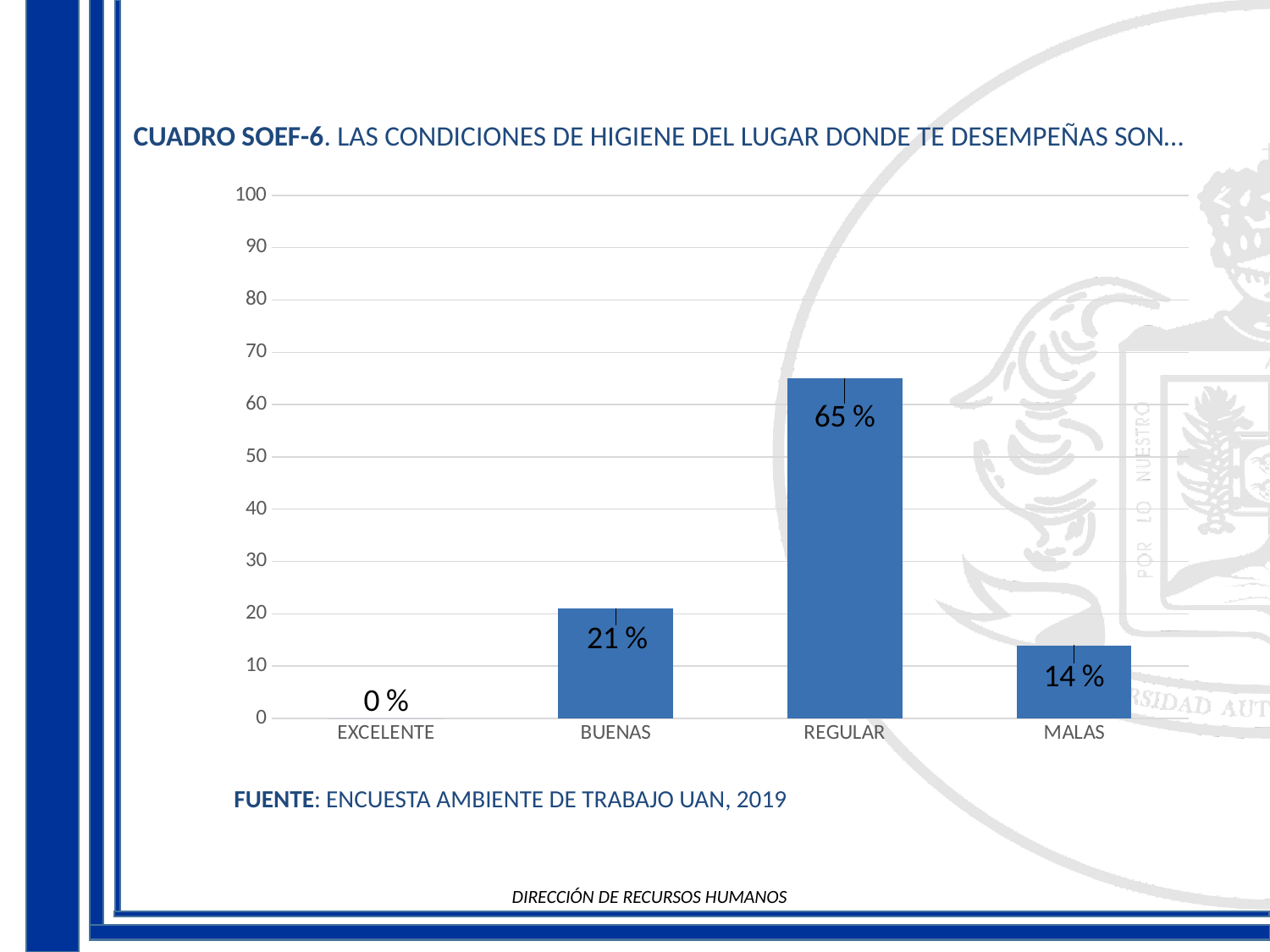
What is the value for REGULAR? 65 % What is the difference between the values for REGULAR and BUENAS? 44 % What is the value for BUENAS? 21 % Is the value for REGULAR greater or less than 60? greater Which category has the lowest value? EXCELENTE What is the difference between the values for BUENAS and MALAS? 7 % How many categories are shown on the x axis? 4 What kind of chart is shown on the slide? bar chart What is the value for MALAS? 14 % Which is larger, the value for BUENAS or the value for MALAS? BUENAS Which category has the highest value? REGULAR What is the value for EXCELENTE? 0 %